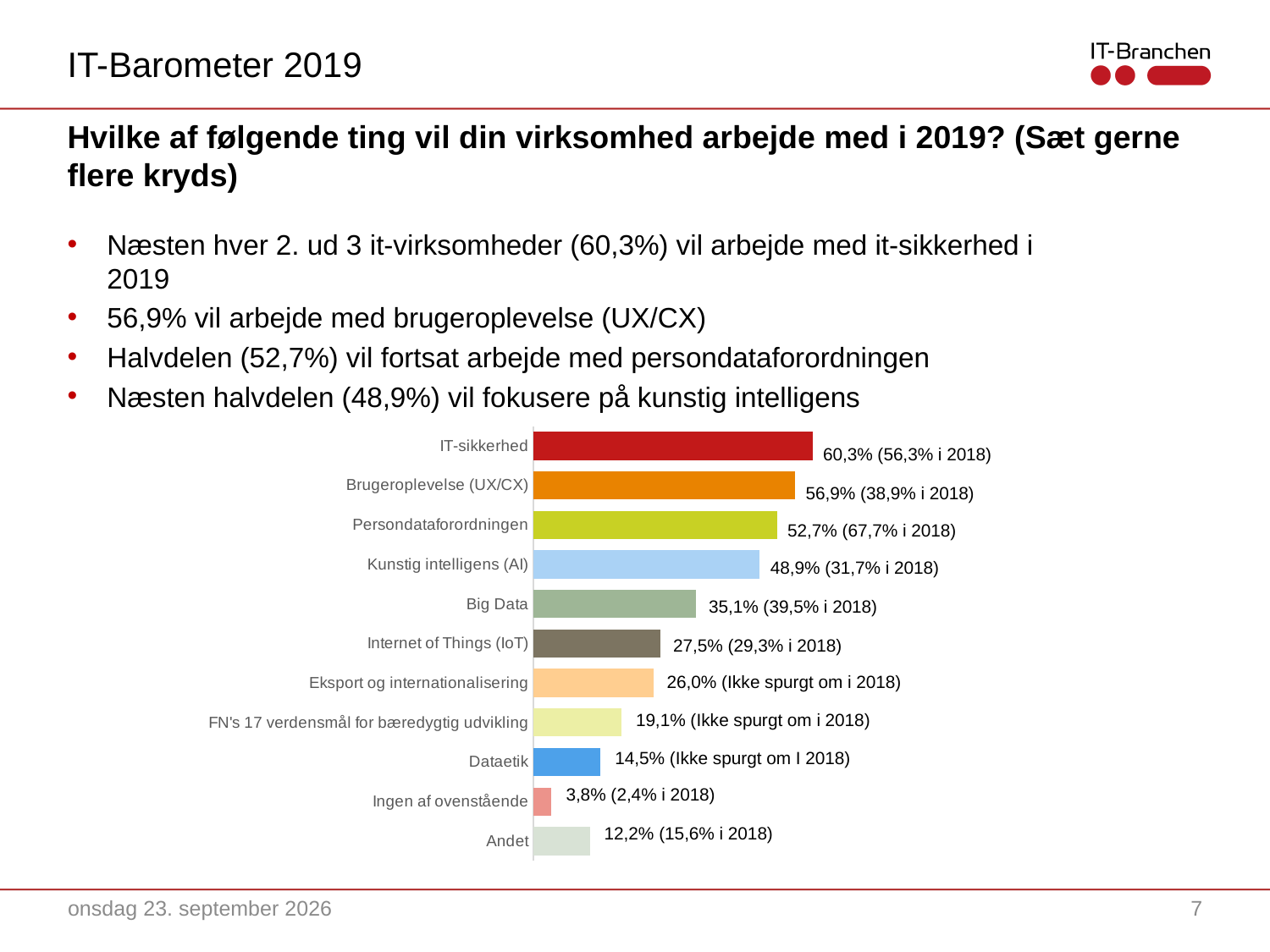
What is the difference between the values for IT-sikkerhed and Brugeroplevelse (UX/CX)? 3,4 percentage points What kind of chart is shown on the slide? Bar chart How many categories are shown in the chart? 11 Which category has the lowest value? Ingen af ovenstående Which category has the highest value? IT-sikkerhed What is the value for IT-sikkerhed in 2019? 60,3% What is the value for Dataetik? 14,5% Which category's data label says it was not asked about in 2018 and has a value of 26,0%? Eksport og internationalisering What is the value for Big Data in 2019? 35,1% What was the value for Persondataforordningen in 2018, according to the data label? 67,7% What is the difference between the values for Big Data and Internet of Things (IoT)? 7,6 percentage points Which is larger, the value for Andet or the value for Ingen af ovenstående? Andet